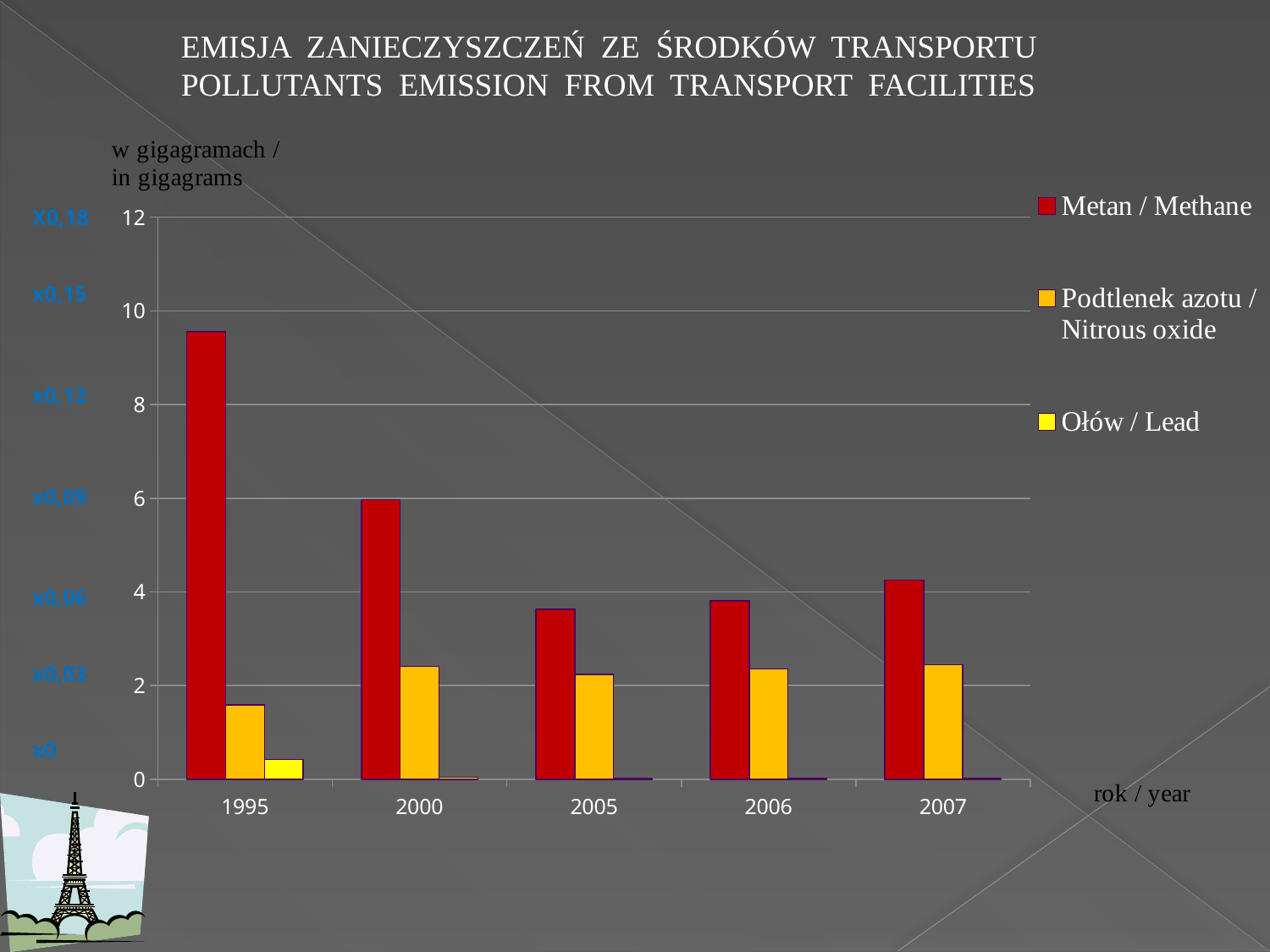
How many series does the legend list? 3 What unit is stated for the values on the chart? gigagrams How many years are shown on the x axis? 5 Does the Metan / Methane value rise or fall from 1995 to 2005? fall Is the Metan / Methane value for 2000 greater or less than 8? less Is the Ołów / Lead value for 1995 greater or less than 2? less Is the Metan / Methane value for 1995 greater or less than 8? greater Which is larger, the Metan / Methane value for 1995 or for 2000? 1995 In which year is the Metan / Methane value highest? 1995 In which year is the Ołów / Lead value highest? 1995 What kind of chart is shown on the slide? bar chart